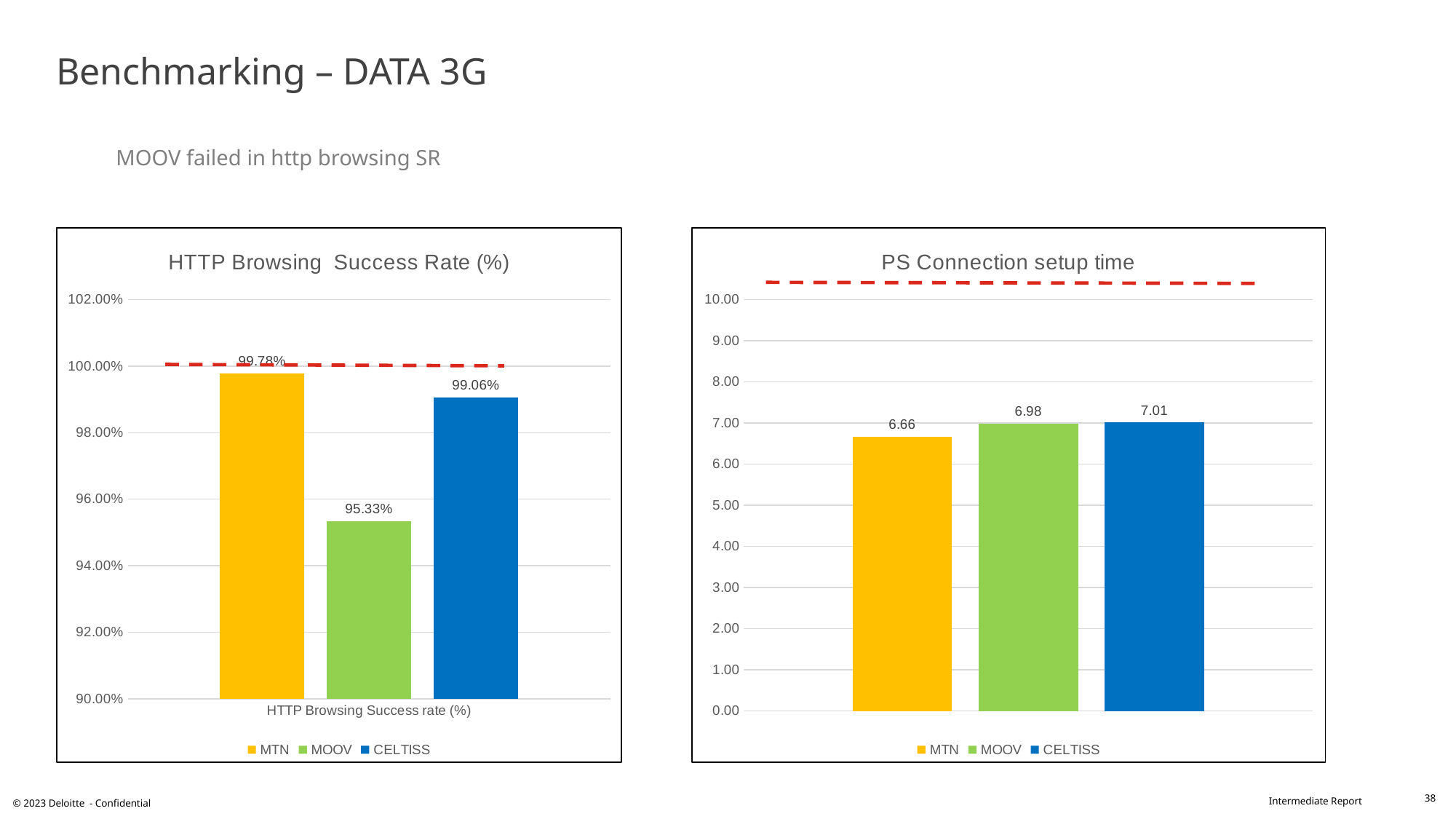
In the PS Connection setup time chart, what is the value for MOOV? 6.98 In the PS Connection setup time chart, what is the value for MTN? 6.66 In the HTTP Browsing Success Rate (%) chart, which operator has the lowest success rate? MOOV In the HTTP Browsing Success Rate (%) chart, which operator has the highest success rate? MTN How many series does the legend of the PS Connection setup time chart list? 3 In the PS Connection setup time chart, what is the difference between the CELTISS and MTN values? 0.35 In the HTTP Browsing Success Rate (%) chart, is the value for MOOV greater or less than 96.00%? less In the HTTP Browsing Success Rate (%) chart, what is the value for CELTISS? 99.06% In the PS Connection setup time chart, which operator has the lowest setup time? MTN What kind of chart is the PS Connection setup time chart? Bar chart In the HTTP Browsing Success Rate (%) chart, what is the value for MOOV? 95.33% In the HTTP Browsing Success Rate (%) chart, what is the difference between the CELTISS and MOOV values? 3.73%